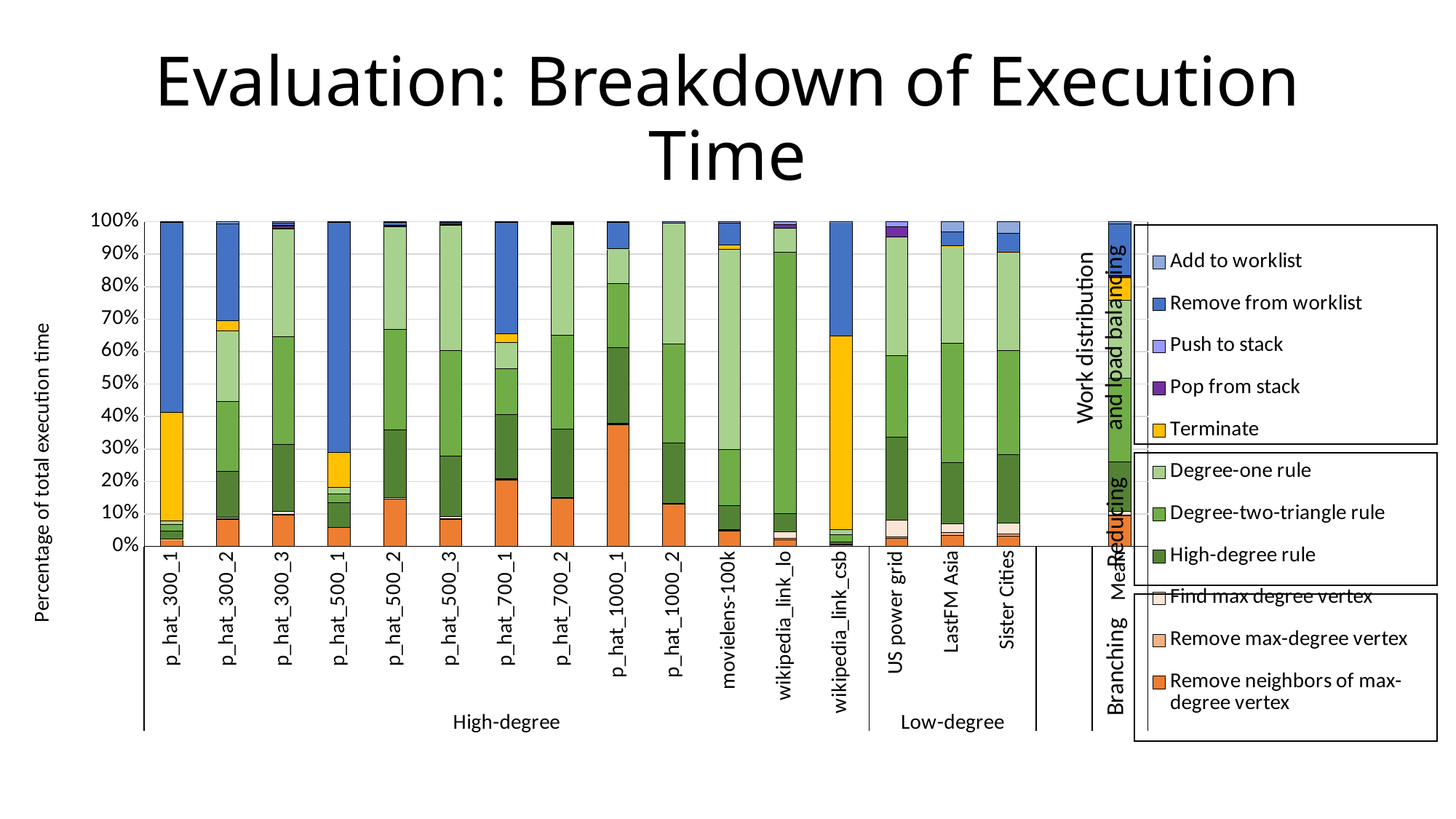
Which category has the largest Remove neighbors of max-degree vertex segment? p_hat_1000_1 How many series does the legend list? 11 Is the Degree-one rule share for wikipedia_link_lo greater or less than 10%? less Which category has the largest Terminate segment? wikipedia_link_csb How many categories are in the High-degree group on the x axis? 13 Is the Remove neighbors of max-degree vertex share for p_hat_1000_1 greater or less than 30%? greater What kind of chart is shown on the slide? Stacked bar chart What is the label of the vertical axis? Percentage of total execution time How many categories are in the Low-degree group on the x axis? 3 Is the Terminate share for wikipedia_link_csb greater or less than 50%? greater Which has the larger Terminate share, p_hat_300_1 or p_hat_500_1? p_hat_300_1